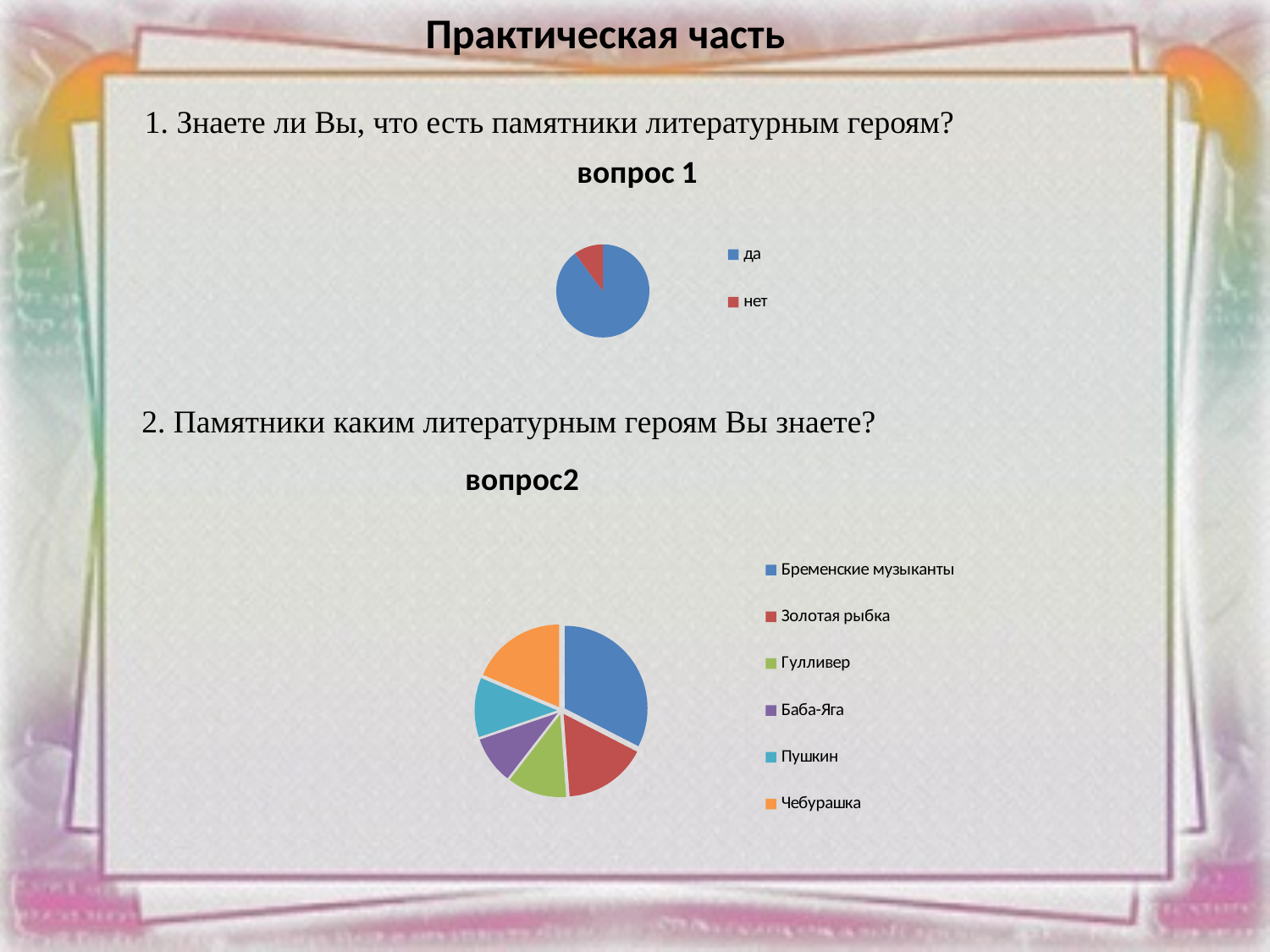
In the chart titled "вопрос2", how many slices does the pie have? 6 In the chart titled "вопрос 1", which slice is larger: да or нет? да In the chart titled "вопрос2", which slice is larger: Бременские музыканты or Золотая рыбка? Бременские музыканты In the chart titled "вопрос 1", how many slices does the pie have? 2 In the chart titled "вопрос 1", which category has the smallest slice? нет In the chart titled "вопрос 1", which category has the largest slice? да What kind of chart is the chart titled "вопрос2"? pie chart In the chart titled "вопрос2", which category has the largest slice? Бременские музыканты In the chart titled "вопрос2", which slice is larger: Чебурашка or Пушкин? Чебурашка What kind of chart is the chart titled "вопрос 1"? pie chart In the chart titled "вопрос2", what colour is the slice for Чебурашка? orange In the chart titled "вопрос2", how many entries does the legend list? 6